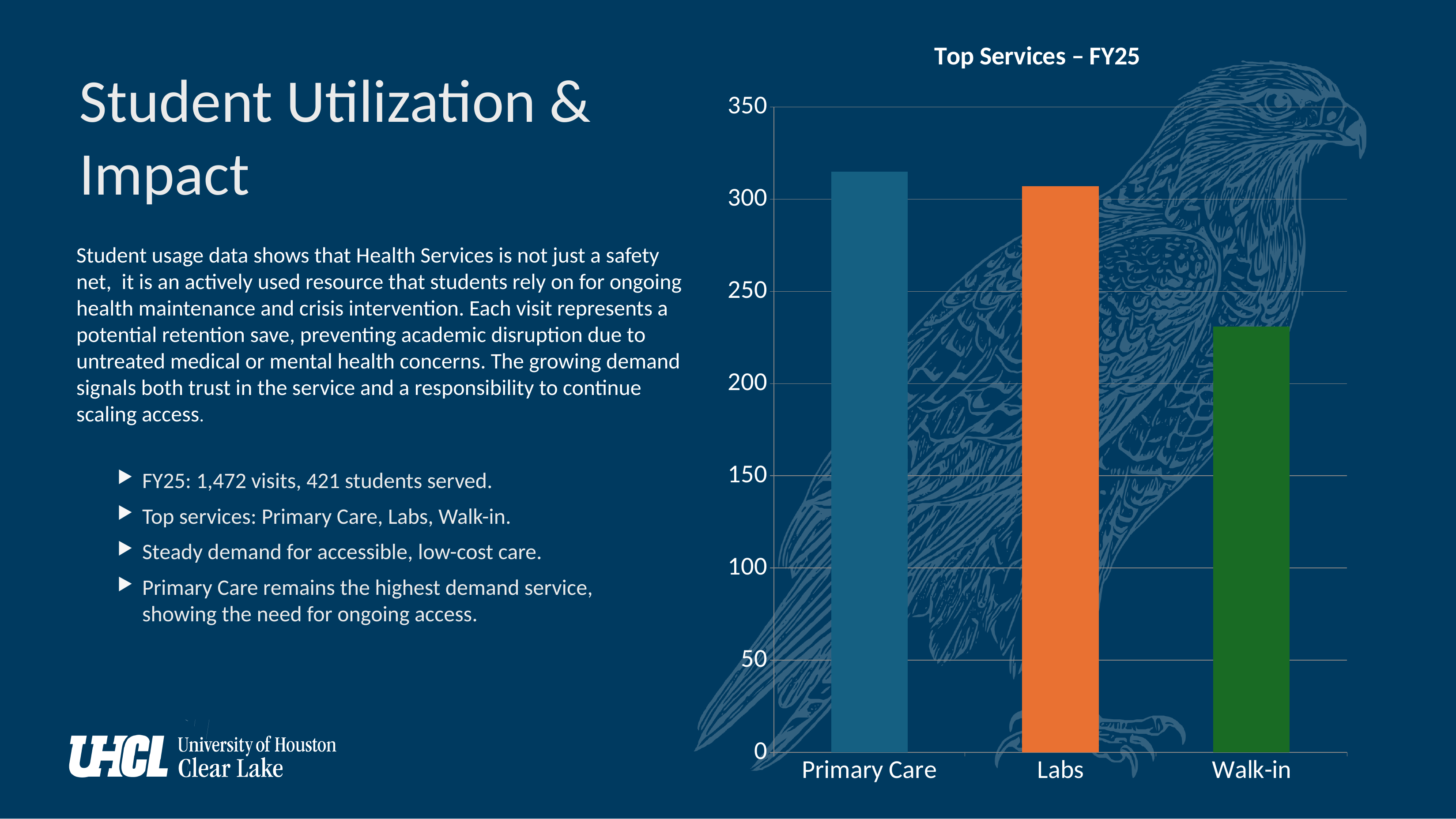
What type of chart is shown on the slide? bar chart Which service has the lowest bar in the chart? Walk-in Which service has the highest bar in the chart? Primary Care How many categories are shown in the chart? 3 Which is larger, the value for Primary Care or the value for Walk-in? Primary Care Which is larger, the value for Labs or the value for Walk-in? Labs Is the value for Walk-in greater or less than 250? less Is the value for Primary Care greater or less than 300? greater What is the title of the chart? Top Services – FY25 Is the value for Walk-in greater or less than 200? greater What colour is the bar for Labs? orange